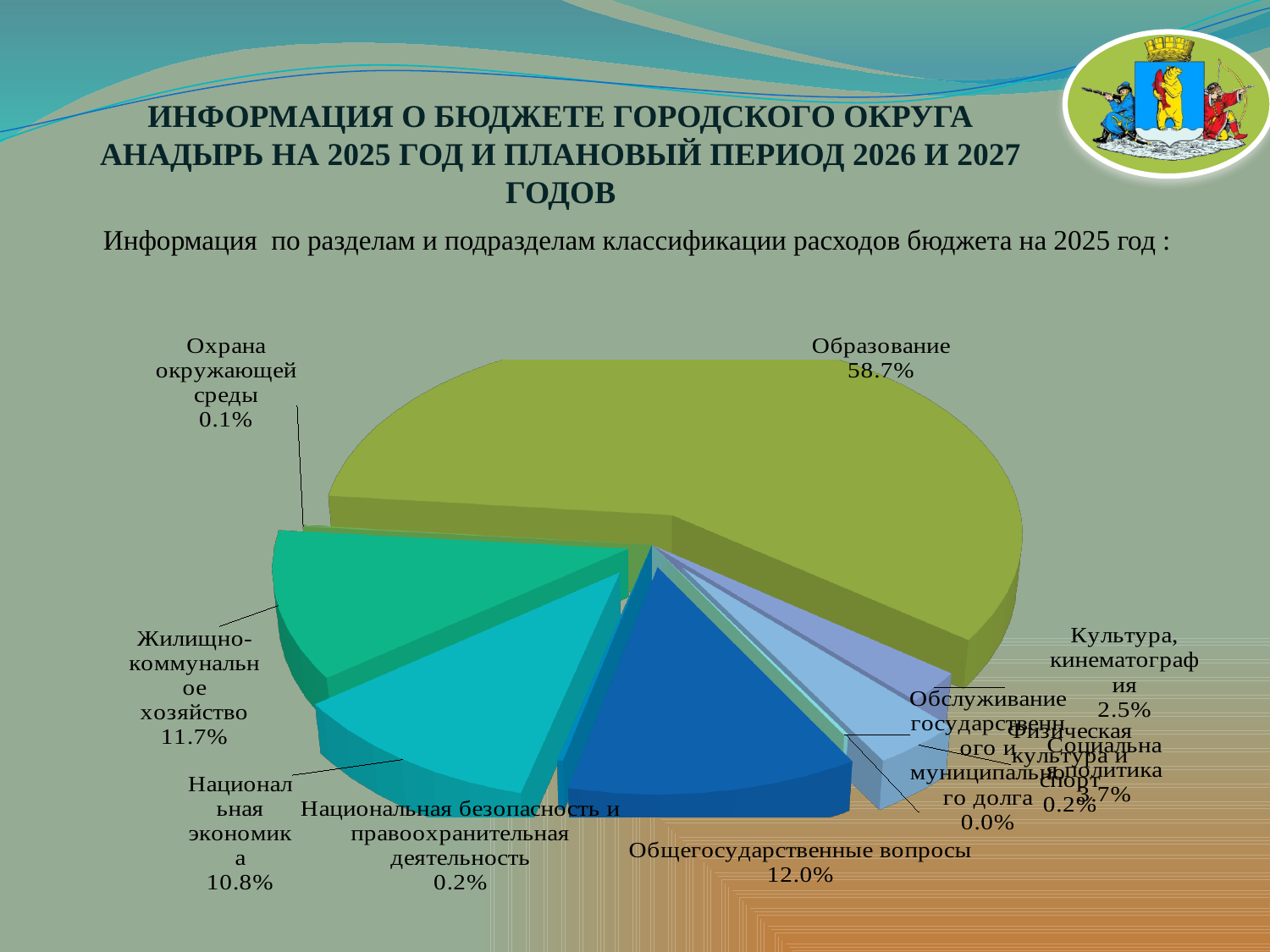
What is the value for Национальная экономика? 10.8% What share is shown for Культура, кинематография? 2.5% What type of chart is shown on the slide? Pie chart What share of the pie does Образование account for? 58.7% Which category has the smallest share of the pie? Обслуживание государственного и муниципального долга What percentage is shown for Жилищно-коммунальное хозяйство? 11.7% Which category has the largest share of the pie? Образование What is the value shown for Общегосударственные вопросы? 12.0% Which is larger: Жилищно-коммунальное хозяйство or Национальная экономика? Жилищно-коммунальное хозяйство What is the difference in percentage points between Общегосударственные вопросы and Жилищно-коммунальное хозяйство? 0.3 What is the value for Социальная политика? 3.7% How many categories are shown in the pie chart? 10